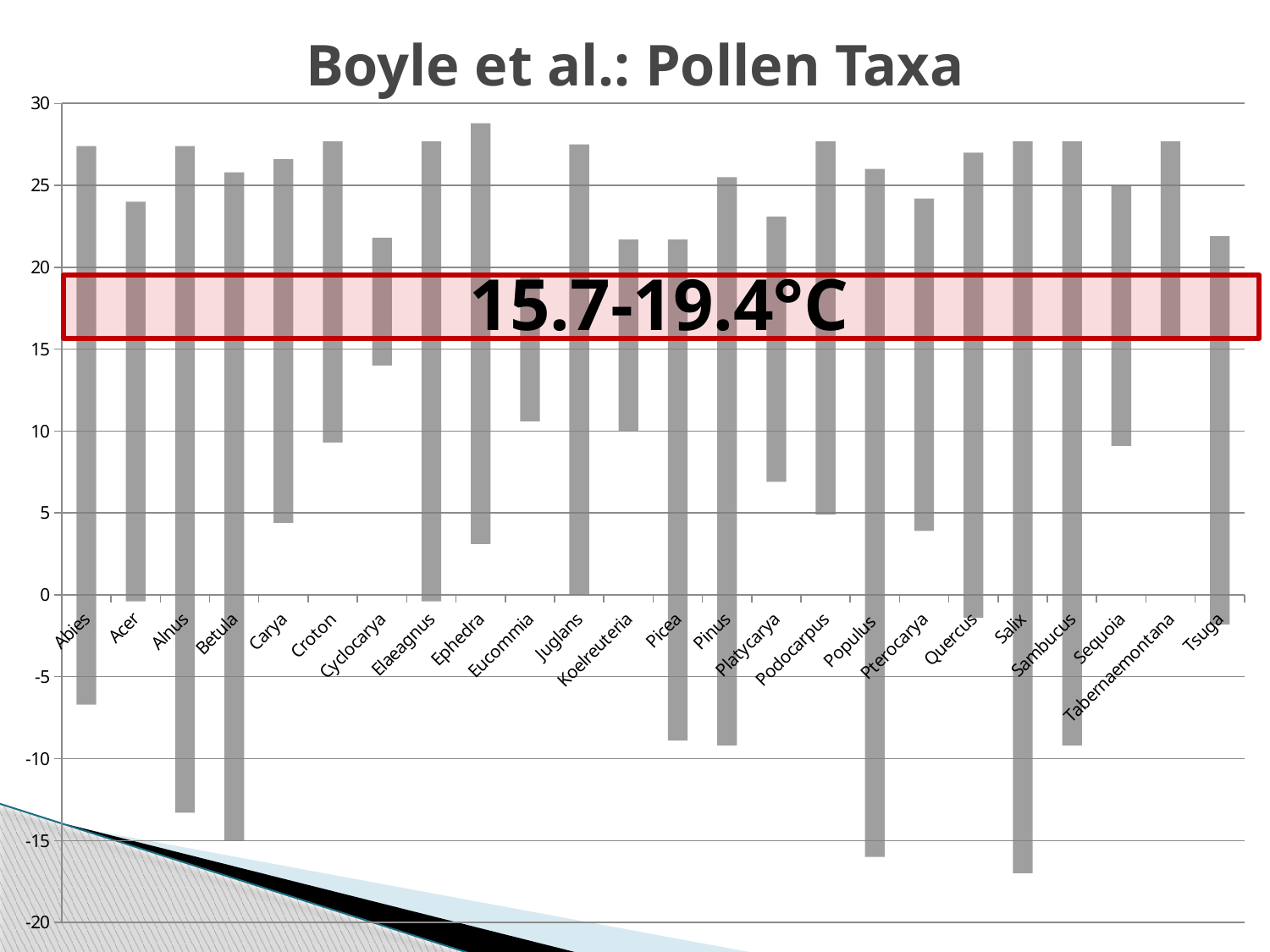
How many pollen taxa are shown along the x axis? 24 Is the lower end of the bar for Platycarya greater or less than 5? greater Is the lower end of the bar for Alnus greater or less than -10? less What kind of chart is shown on the slide? bar chart Is the lower end of the bar for Salix greater or less than -15? less Which bar reaches higher at its top: Ephedra or Acer? Ephedra What temperature range is written in the highlighted red band across the chart? 15.7-19.4°C What is the title of the chart? Boyle et al.: Pollen Taxa Which bar extends lower at its bottom: Salix or Abies? Salix Which taxon has the highest upper end of its bar? Ephedra